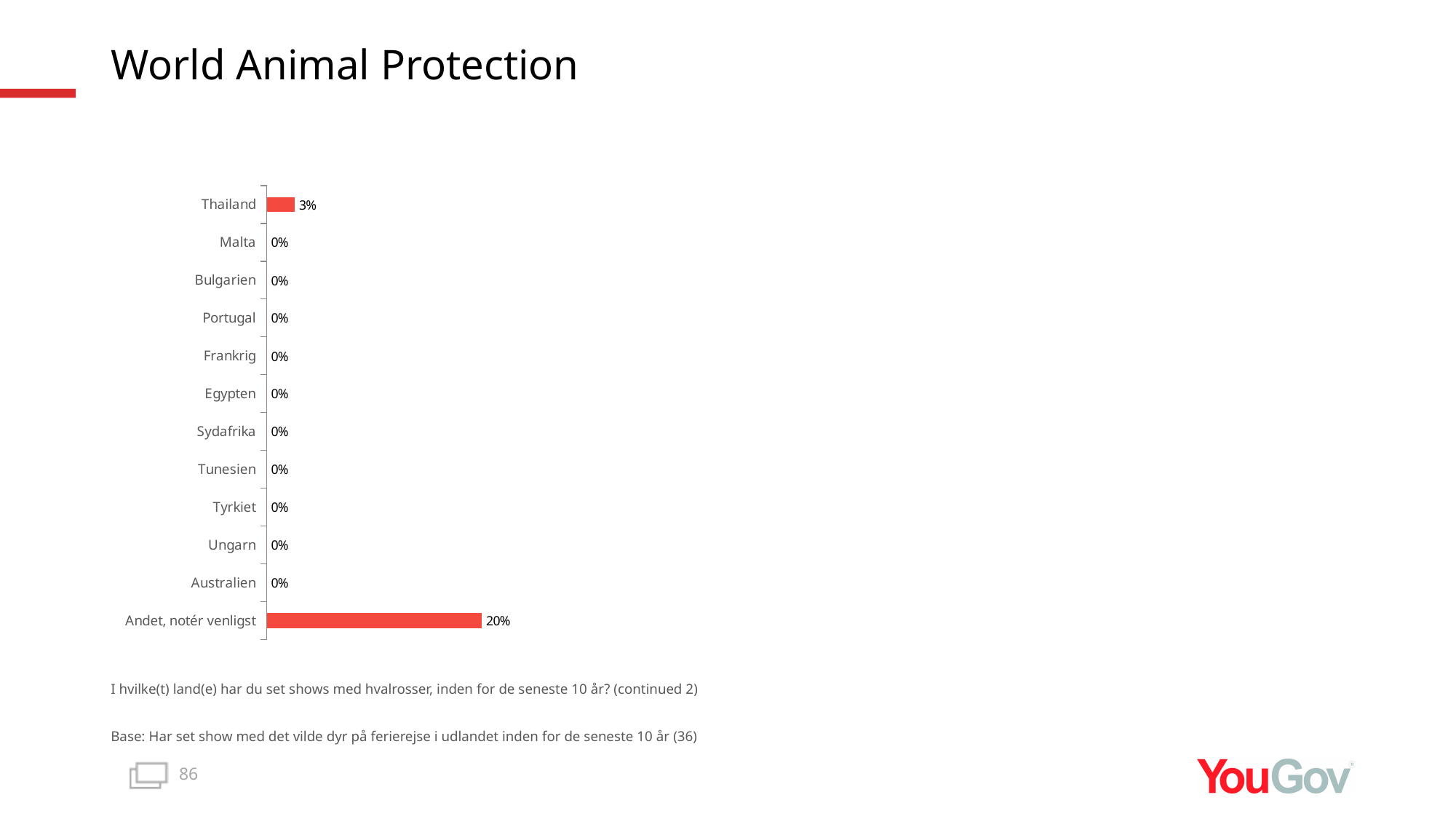
What is the value for Malta? 0% How many categories have a value of 0%? 10 What is the difference between the values for Andet, notér venligst and Thailand? 17% What kind of chart is shown on the slide? Bar chart Which category has the highest value? Andet, notér venligst Which is larger, the value for Thailand or the value for Egypten? Thailand What is the title of the slide? World Animal Protection How many categories are shown on the chart? 12 What is the value for Andet, notér venligst? 20% What is the value for Tyrkiet? 0% What is the value for Thailand? 3% What colour are the bars in the chart? Red